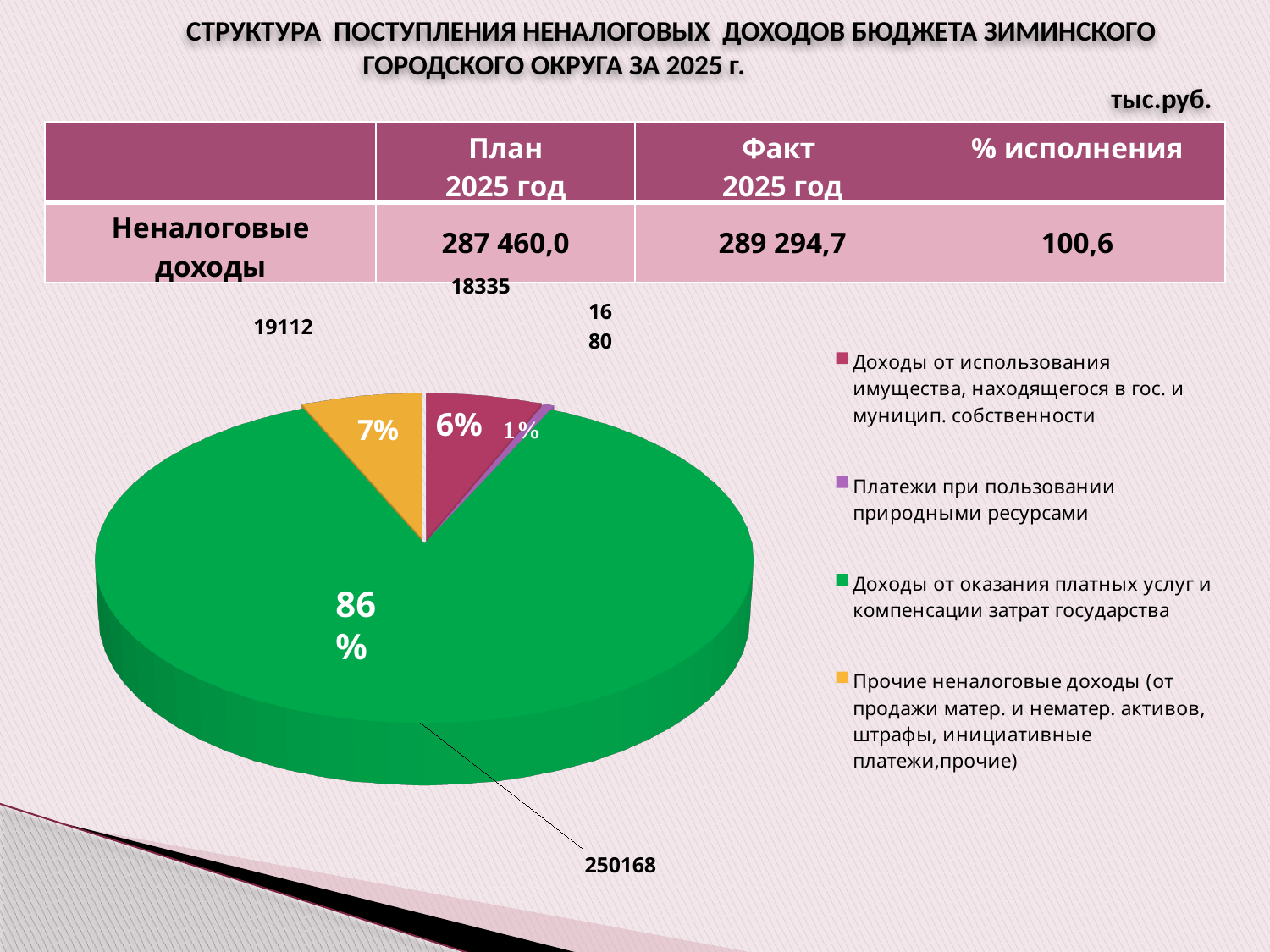
What share of the pie does "Прочие неналоговые доходы" take? 7% What share of the pie does "Доходы от оказания платных услуг и компенсации затрат государства" take? 86% What is the value shown for "Прочие неналоговые доходы"? 19112 What is the value shown for "Доходы от оказания платных услуг и компенсации затрат государства"? 250168 What kind of chart is shown on the slide? pie chart Which category has the smallest slice of the pie? Платежи при пользовании природными ресурсами What is the value shown for "Доходы от использования имущества, находящегося в гос. и муницип. собственности"? 18335 Which category has the largest slice of the pie? Доходы от оказания платных услуг и компенсации затрат государства How many slices does the pie chart have? 4 What share of the pie does "Доходы от использования имущества, находящегося в гос. и муницип. собственности" take? 6% How many entries does the legend of the pie chart list? 4 What is the difference between the values for "Прочие неналоговые доходы" and "Доходы от использования имущества, находящегося в гос. и муницип. собственности"? 777